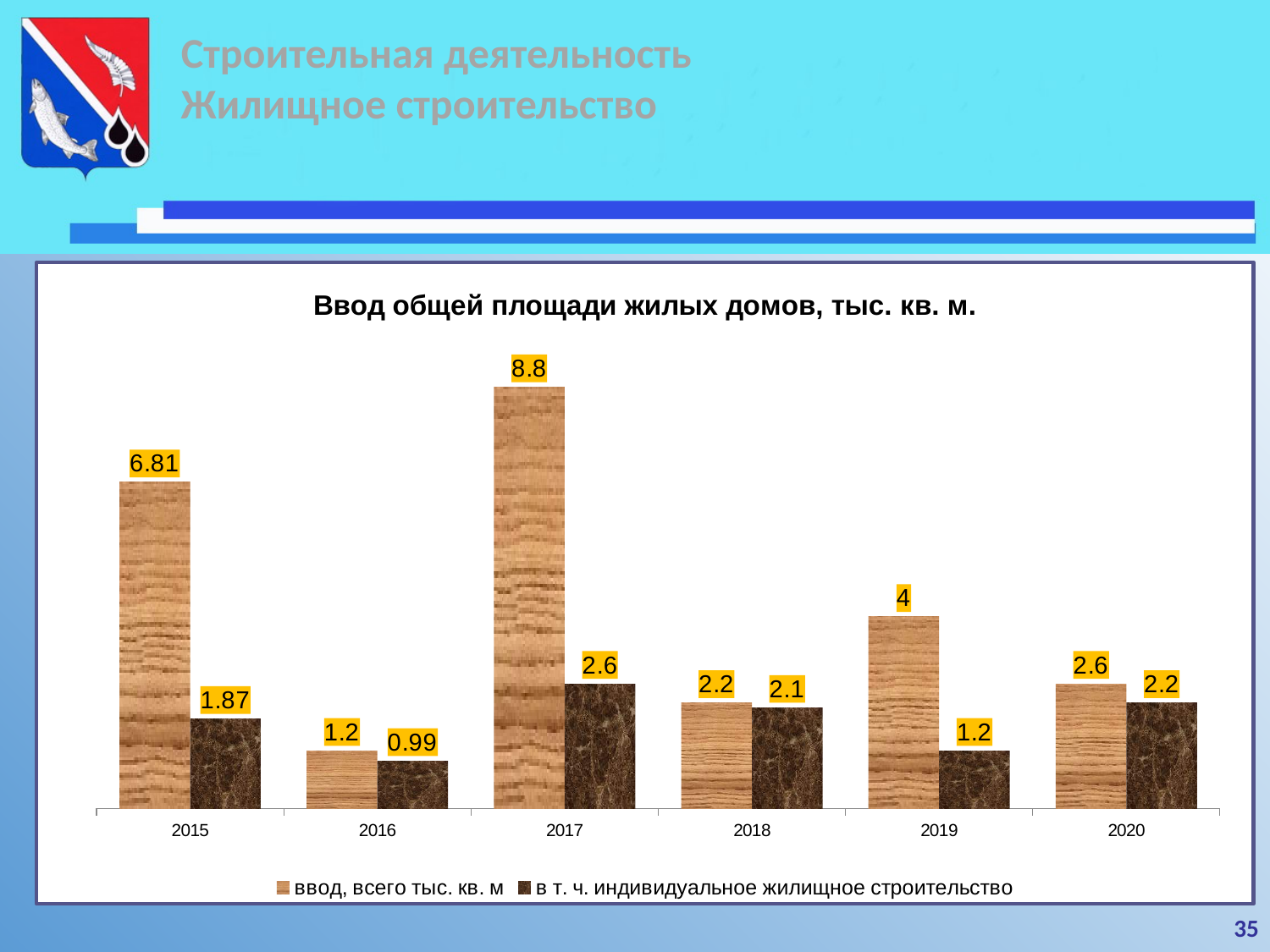
What is the value of "ввод, всего тыс. кв. м" for 2019? 4 Which year has the lowest value for "в т. ч. индивидуальное жилищное строительство"? 2016 How many years are shown on the x axis? 6 How many series does the legend list? 2 What is the value of "в т. ч. индивидуальное жилищное строительство" for 2015? 1.87 Does the value of "ввод, всего тыс. кв. м" rise or fall from 2017 to 2018? fall What is the value of "ввод, всего тыс. кв. м" for 2017? 8.8 What kind of chart is shown on the slide? bar chart What is the difference between "ввод, всего тыс. кв. м" and "в т. ч. индивидуальное жилищное строительство" in 2015? 4.94 What is the title of the chart? Ввод общей площади жилых домов, тыс. кв. м. Which is larger: "ввод, всего тыс. кв. м" in 2019 or in 2020? 2019 Which year has the highest value for "ввод, всего тыс. кв. м"? 2017